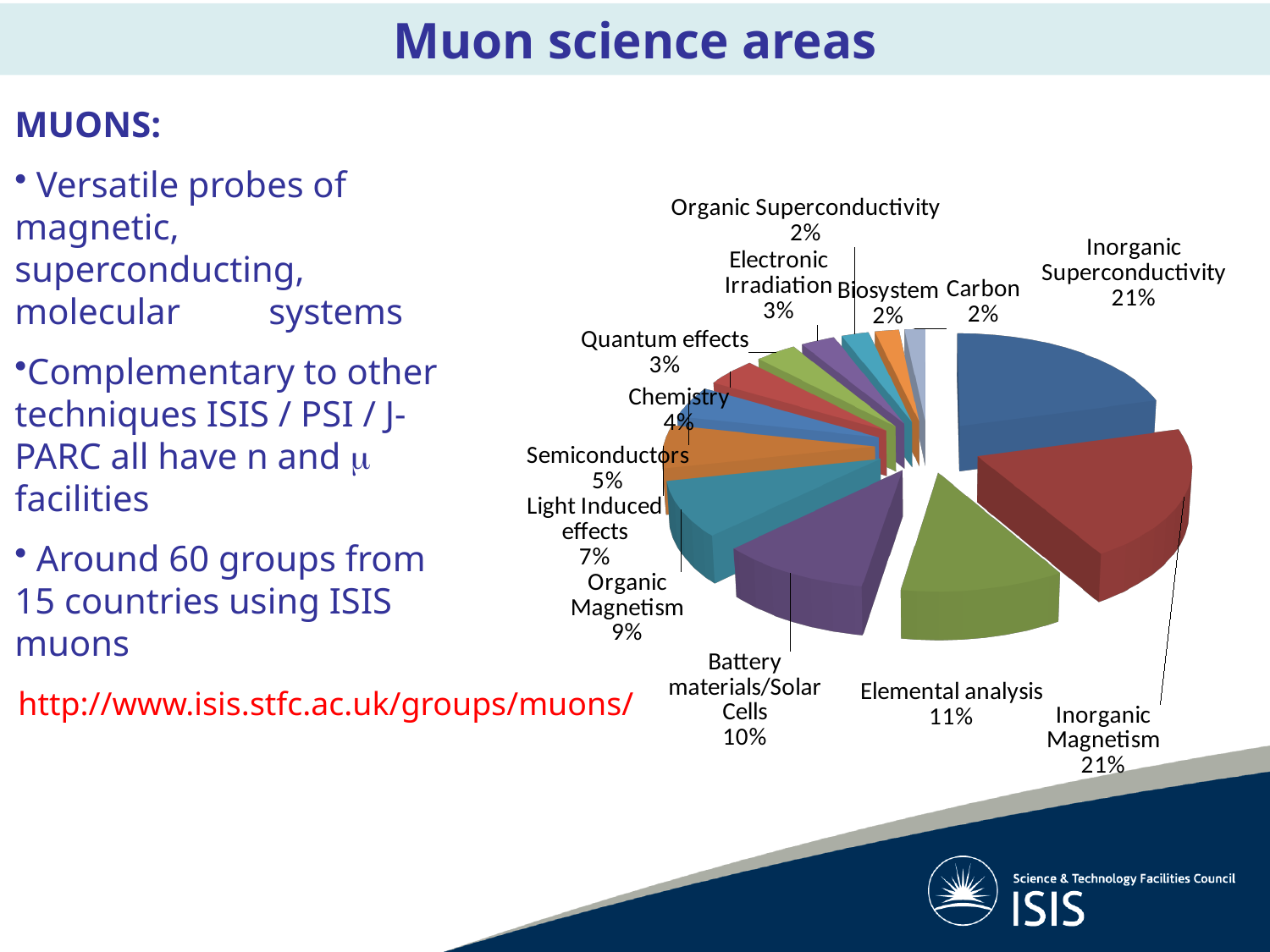
What share of the pie does Inorganic Superconductivity have? 21% Which is larger, the share for Elemental analysis or the share for Battery materials/Solar Cells? Elemental analysis What percentage is shown for Elemental analysis? 11% What percentage is shown for Organic Magnetism? 9% How many categories (slices) does the pie chart have? 13 What kind of chart is shown on the slide? pie chart What percentage is shown for Chemistry? 4% What is the difference in percentage points between Inorganic Magnetism and Organic Magnetism? 12 What percentage is shown for Battery materials/Solar Cells? 10% What percentage is shown for Light Induced effects? 7% What percentage is shown for Organic Superconductivity? 2% What percentage is shown for Semiconductors? 5%